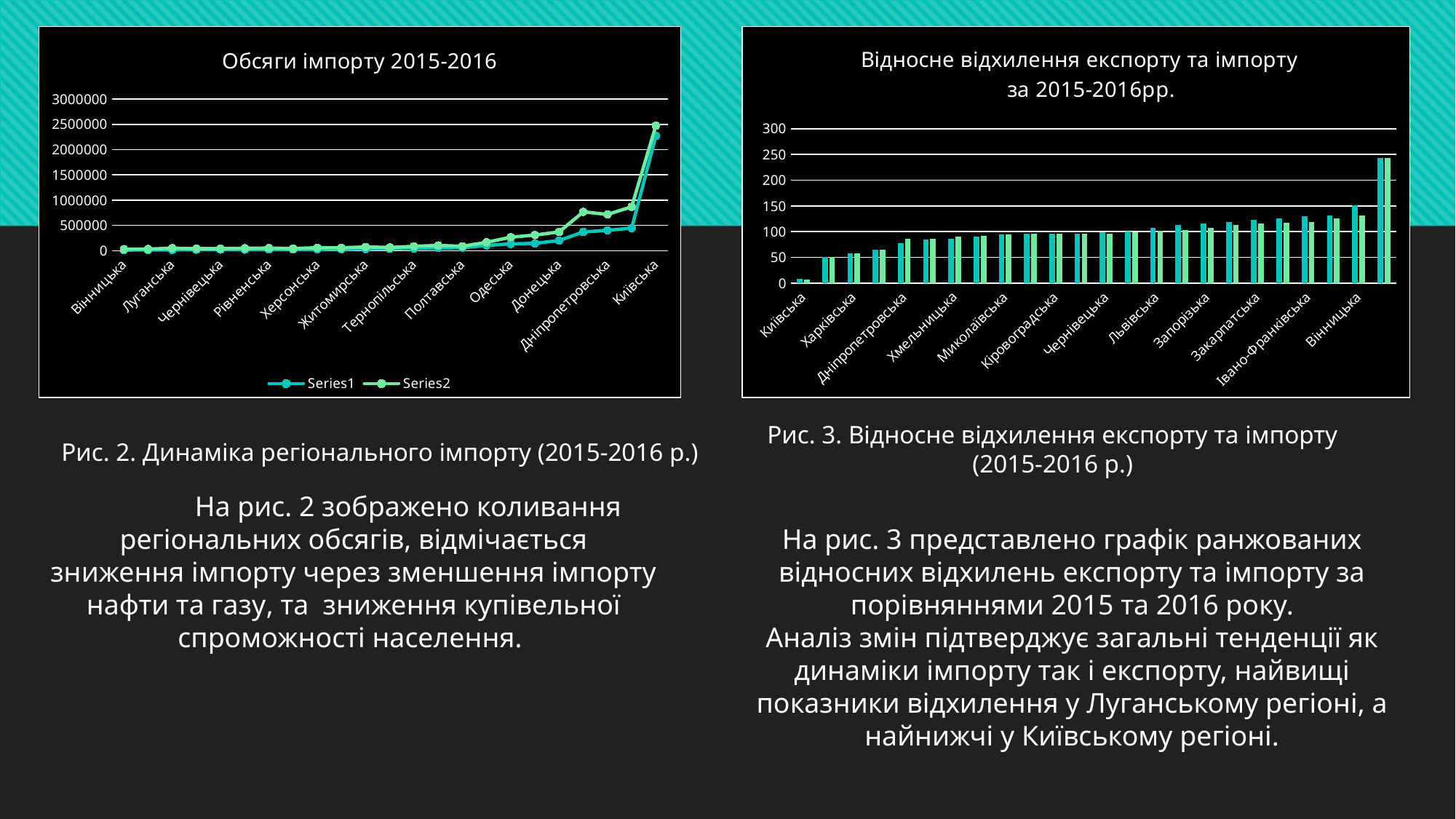
In the left chart 'Обсяги імпорту 2015-2016', how many series does the legend list? 2 In the right chart 'Відносне відхилення експорту та імпорту', are the values for Київська greater or less than 50? less In the left chart 'Обсяги імпорту 2015-2016', is the value for Вінницька greater or less than 500000? less In the left chart 'Обсяги імпорту 2015-2016', which has the larger value: Київська or Вінницька? Київська What kind of chart is the right chart titled 'Відносне відхилення експорту та імпорту за 2015-2016рр.'? bar chart In the right chart 'Відносне відхилення експорту та імпорту', which labelled category has the lowest values? Київська What is the title of the left chart? Обсяги імпорту 2015-2016 In the right chart 'Відносне відхилення експорту та імпорту', are the values for Львівська greater or less than 50? greater In the left chart 'Обсяги імпорту 2015-2016', do the values generally rise or fall from left to right along the x axis? rise What kind of chart is the left chart titled 'Обсяги імпорту 2015-2016'? line chart In the left chart 'Обсяги імпорту 2015-2016', which labelled category has the highest values? Київська